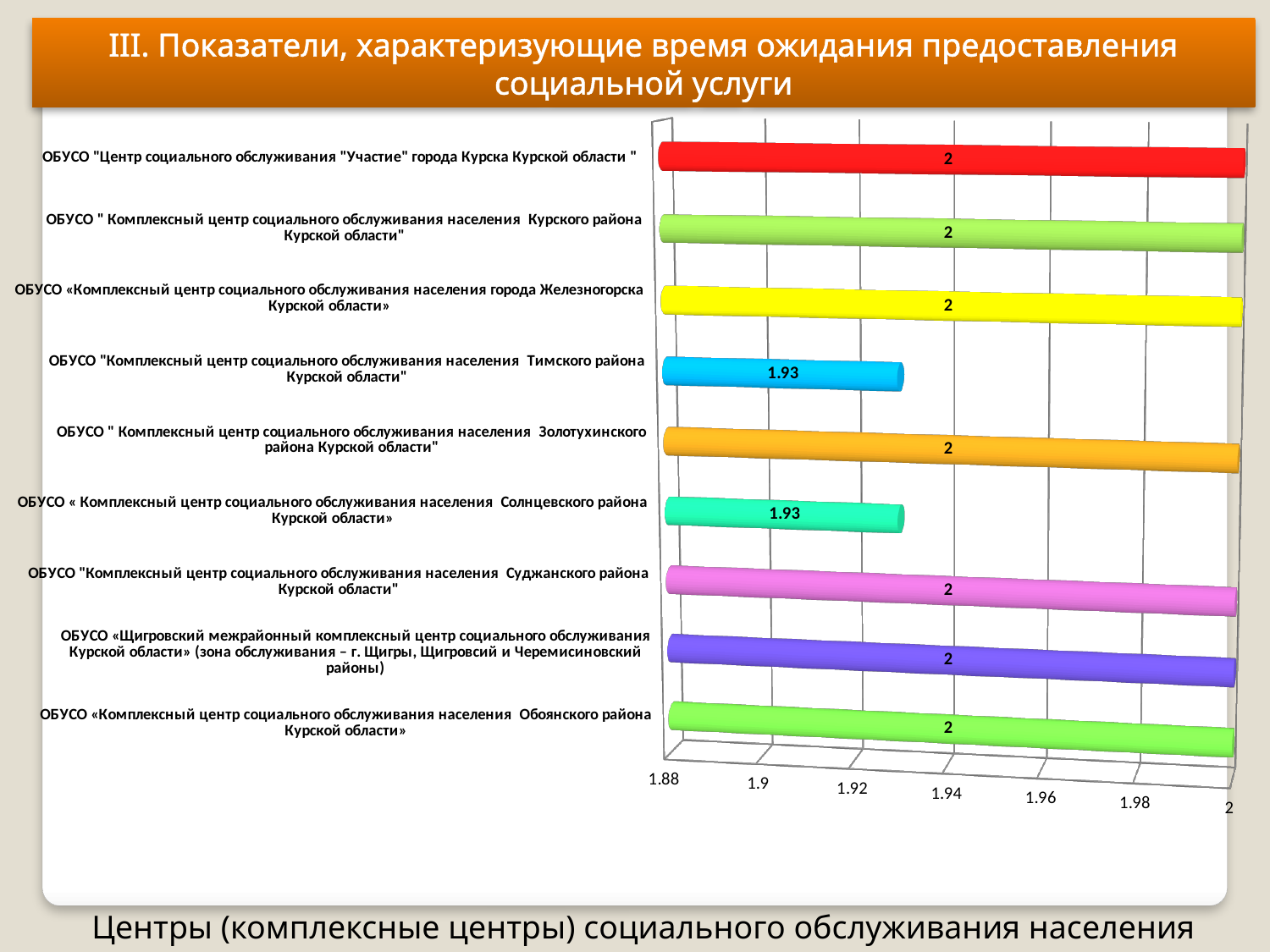
Is the value for the Тимского района centre greater or less than 1.96? less What is the value for ОБУСО «Комплексный центр социального обслуживания населения Солнцевского района Курской области»? 1.93 What is the lowest value shown on the chart? 1.93 What is the value for ОБУСО «Комплексный центр социального обслуживания населения Обоянского района Курской области»? 2 What kind of chart is shown on the slide? bar chart How many organisations (bars) are plotted on the chart? 9 What is the value for ОБУСО "Комплексный центр социального обслуживания населения Тимского района Курской области"? 1.93 What is the value for ОБУСО "Центр социального обслуживания "Участие" города Курска Курской области"? 2 How many organisations have a value of 2? 7 What is the difference between the value for the Суджанского района centre and the value for the Тимского района centre? 0.07 What is the minimum value shown on the horizontal axis? 1.88 Which is larger: the value for the Золотухинского района centre or the value for the Солнцевского района centre? Золотухинского района centre